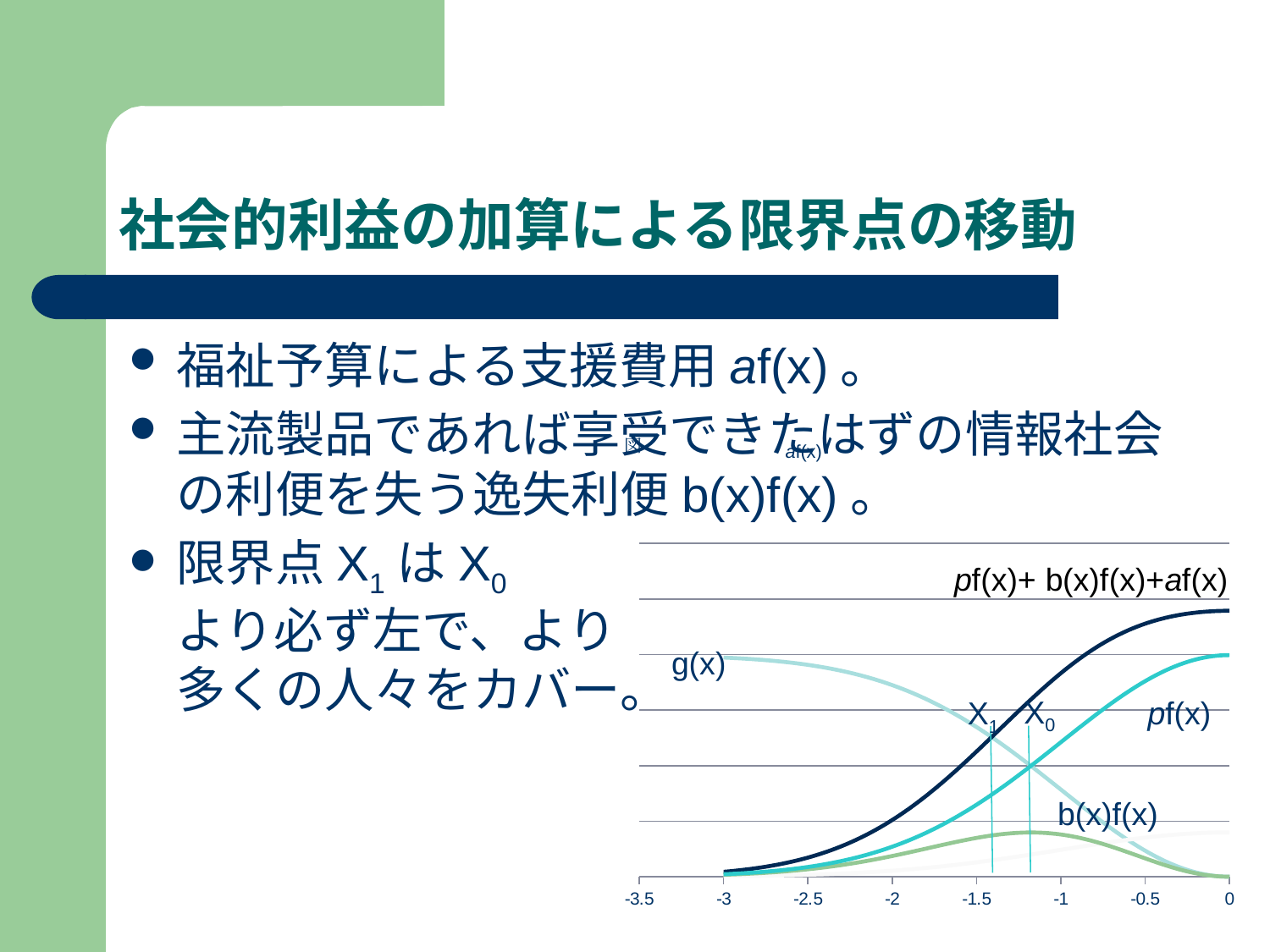
Does the curve labelled b(x)f(x) rise or fall between x = -1 and x = 0? falls How many labelled curves are plotted on the chart? 4 What is the leftmost tick label on the x axis? -3.5 At x = 0, which curve is higher: pf(x)+b(x)f(x)+af(x) or pf(x)? pf(x)+b(x)f(x)+af(x) Is the x value of the point X1 greater or less than -1? less What kind of chart is shown on the slide? line chart Does the curve labelled pf(x) rise or fall as x increases from -3 to 0? rises Which of the two marked points, X1 or X0, lies further to the left on the x axis? X1 At x = -3, which curve is higher: g(x) or pf(x)? g(x) What is the label of the topmost curve on the chart? pf(x)+ b(x)f(x)+af(x) Is the x value of the point X0 greater or less than -1.5? greater Does the curve labelled g(x) rise or fall as x increases from -3 to 0? falls